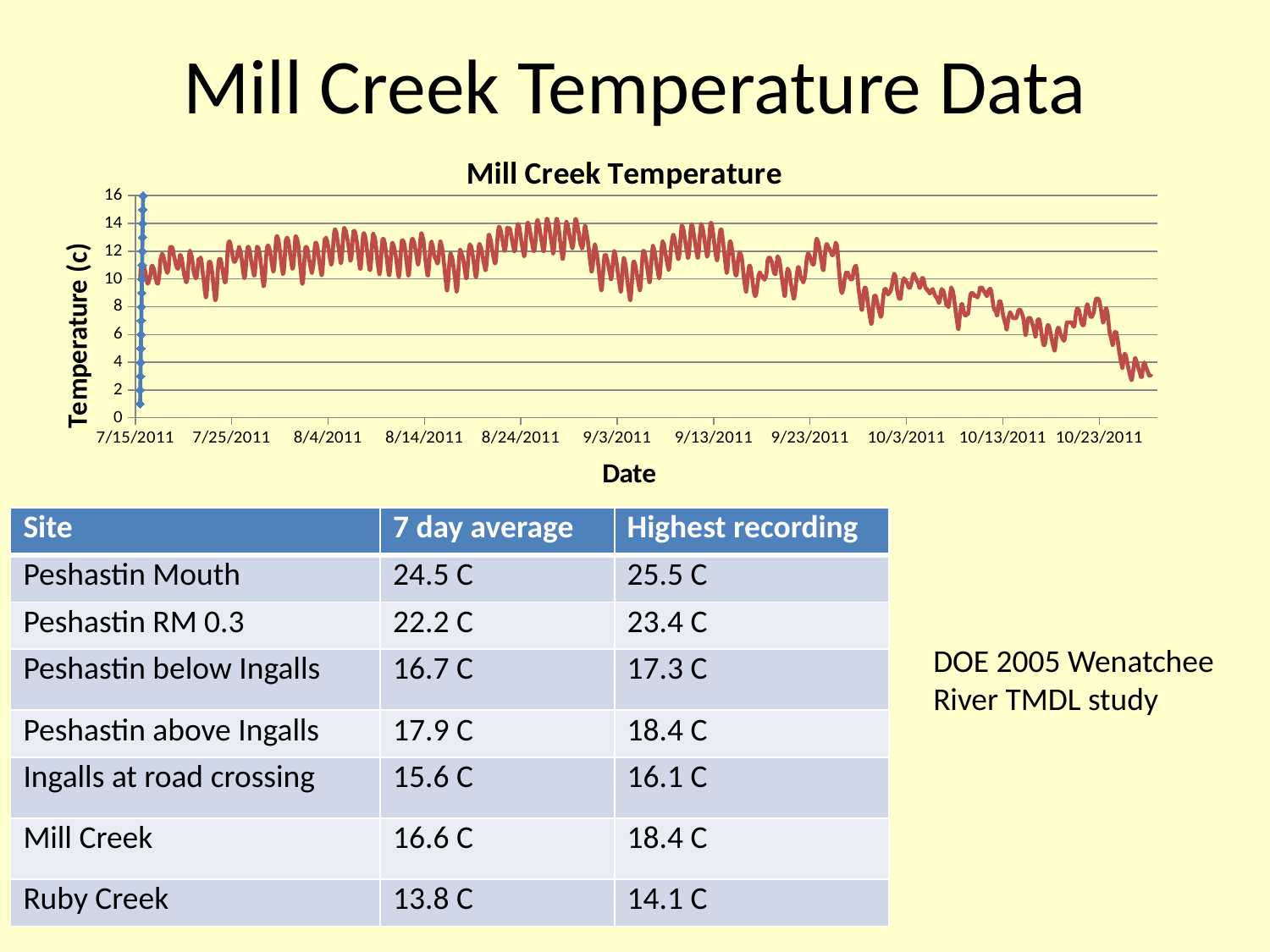
Is the temperature around 10/13/2011 greater or less than 12? less Is the temperature at the end of the series (late October 2011) greater or less than 6? less Which is higher, the temperature around 8/24/2011 or the temperature around 10/23/2011? 8/24/2011 What is the title of the chart? Mill Creek Temperature Is the temperature around 10/23/2011 greater or less than 10? less Overall, does the temperature rise or fall along the x axis from 7/15/2011 to late October 2011? fall What is the label of the vertical axis of the chart? Temperature (c) What is the highest value shown on the vertical axis of the chart? 16 What kind of chart is shown on the slide? line chart